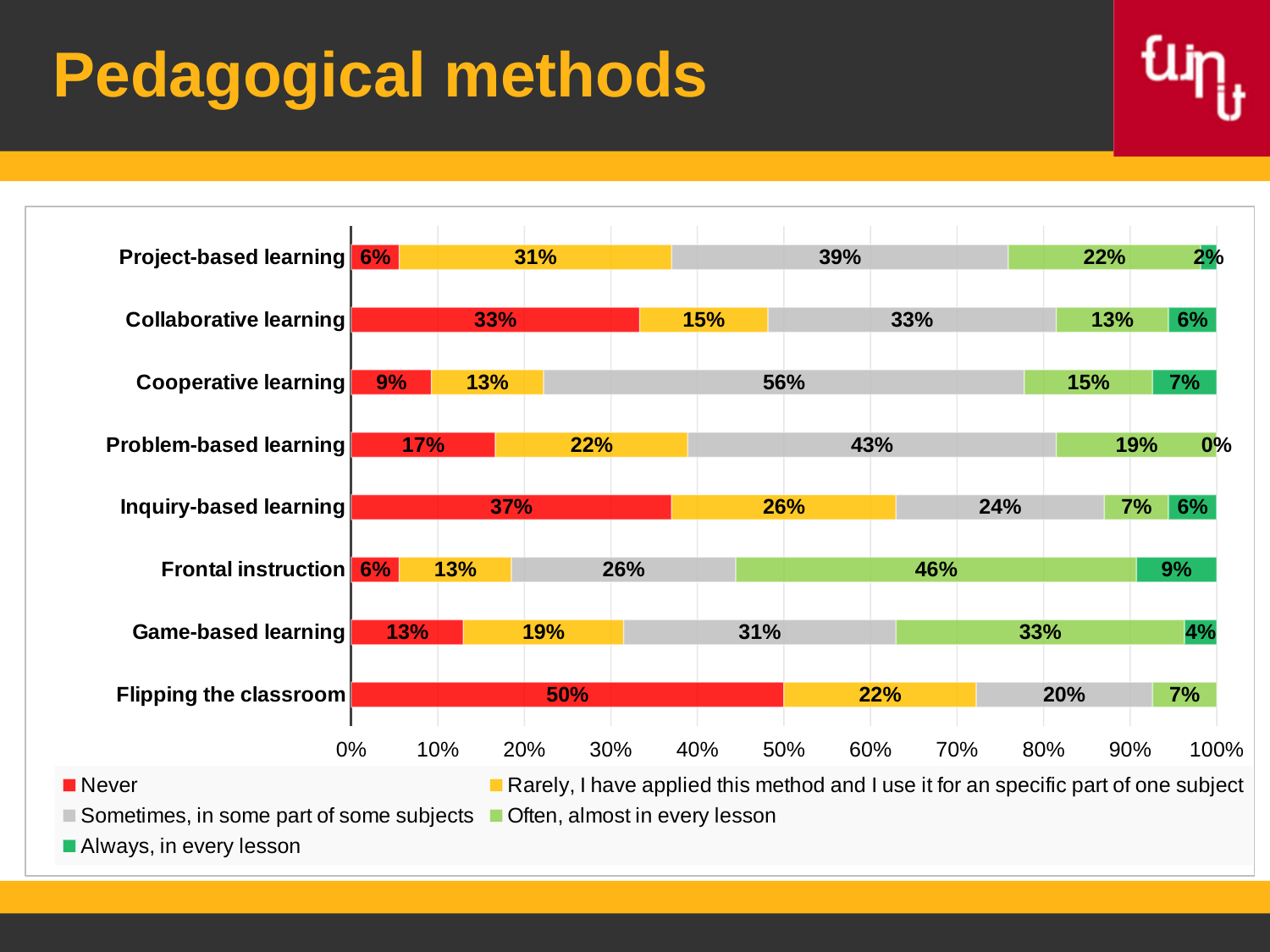
How many series does the legend list? 5 What is the difference between the 'Never' values for Inquiry-based learning and Collaborative learning? 4% What is the 'Never' value for Flipping the classroom? 50% Which pedagogical method has the lowest 'Often, almost in every lesson' value? Inquiry-based learning and Flipping the classroom (both 7%) How many pedagogical methods (categories) are shown in the chart? 8 What is the total of the Project-based learning stacked bar? 100% What is the 'Sometimes, in some part of some subjects' value for Cooperative learning? 56% Which colour represents the 'Never' series in the legend? Red What is the 'Often, almost in every lesson' value for Frontal instruction? 46% What kind of chart is shown on the slide? Stacked bar chart Which has a larger 'Rarely' value: Project-based learning or Game-based learning? Project-based learning Which pedagogical method has the highest 'Never' value? Flipping the classroom